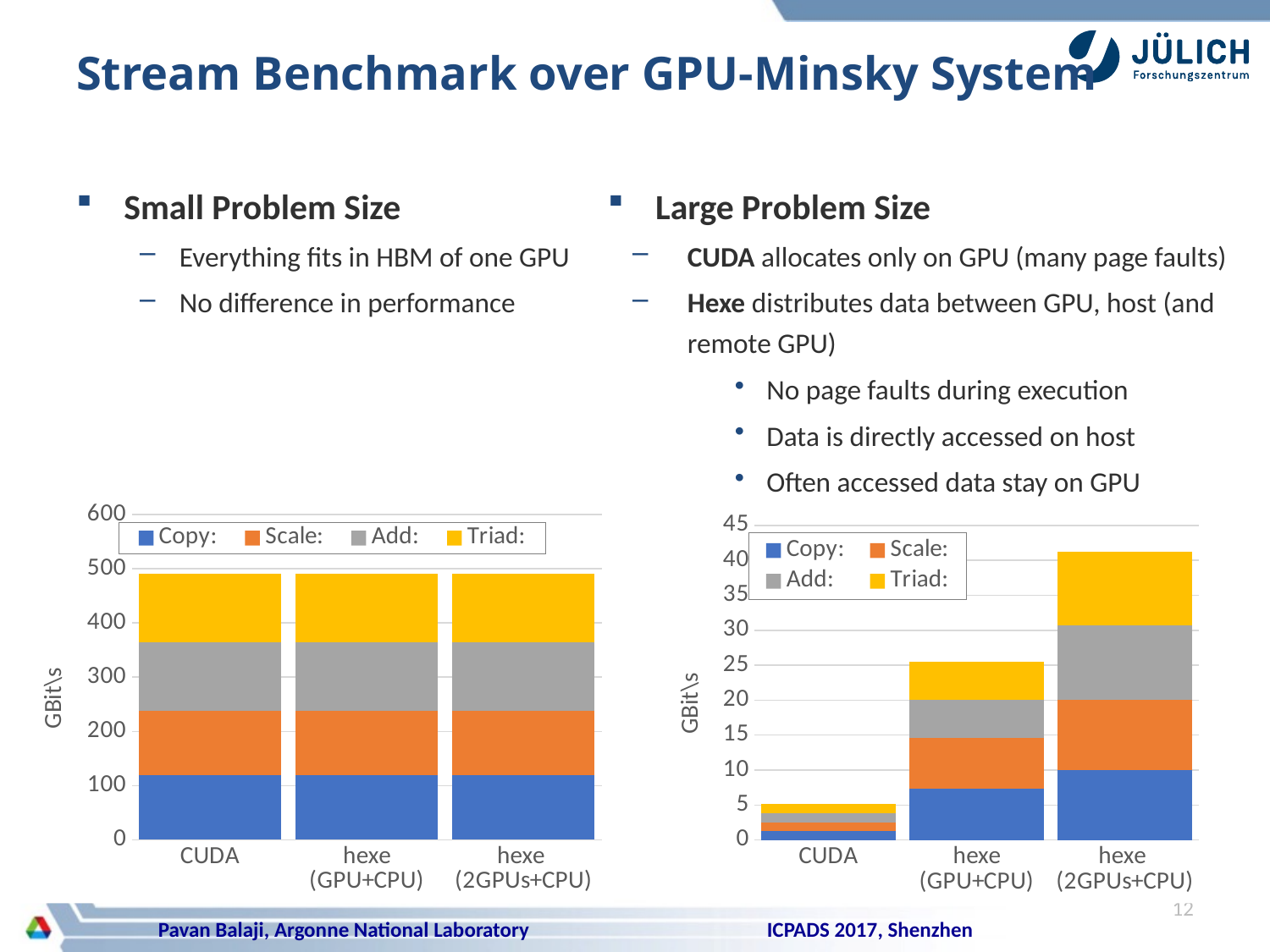
How many categories are shown on the x axis of the right chart? 3 In the right chart, which has a larger total stacked value, hexe (GPU+CPU) or hexe (2GPUs+CPU)? hexe (2GPUs+CPU) In the right chart, is the total stacked value for hexe (GPU+CPU) greater or less than 20? greater In the right chart, is the total stacked value for CUDA greater or less than 10? less What kind of chart is the left chart on the slide? stacked bar chart What is the y-axis label of the left chart? GBit\s In the right chart, do the total stacked values rise or fall from left to right along the x axis? rise How many series does the legend of the right chart list? 4 In the left chart, is the total stacked value for CUDA greater or less than 400? greater In the right chart, which category has the highest total stacked value? hexe (2GPUs+CPU) In the right chart, which category has the lowest total stacked value? CUDA